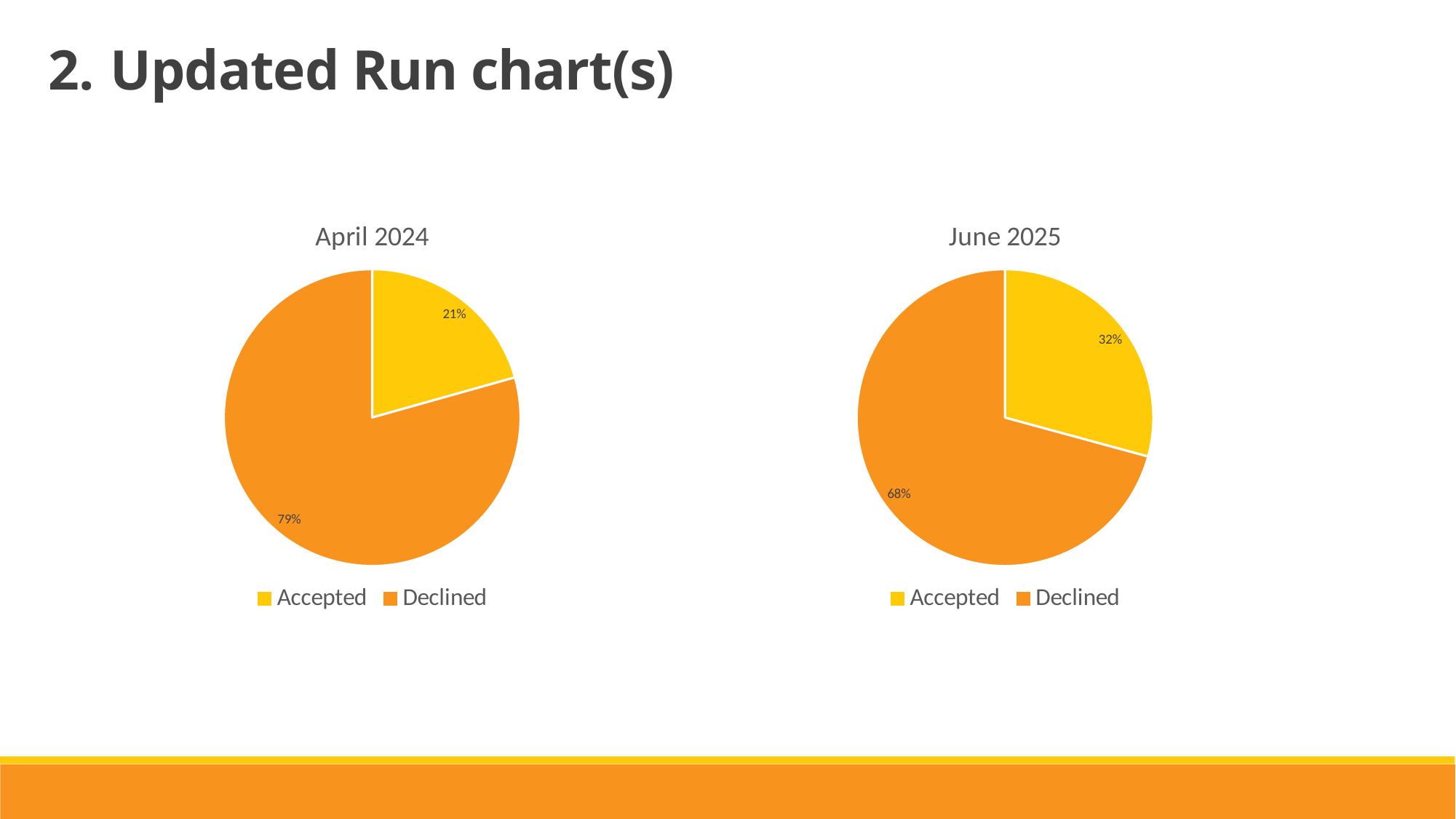
In the June 2025 chart, what percentage is labelled for Accepted? 32% Is the Accepted share larger in the April 2024 chart or the June 2025 chart? June 2025 In the June 2025 chart, which category has the smallest slice? Accepted In the April 2024 chart, what percentage is labelled for Declined? 79% In the June 2025 chart, what percentage is labelled for Declined? 68% In the April 2024 chart, what colour is the Accepted slice? Yellow In the April 2024 chart, which category has the largest slice? Declined How many categories does the legend of the June 2025 chart list? 2 In the April 2024 chart, what percentage is labelled for Accepted? 21% In the June 2025 chart, what is the difference between the Declined and Accepted percentages? 36% What is the title of the chart on the right side of the slide? June 2025 What type of chart is the April 2024 chart? Pie chart